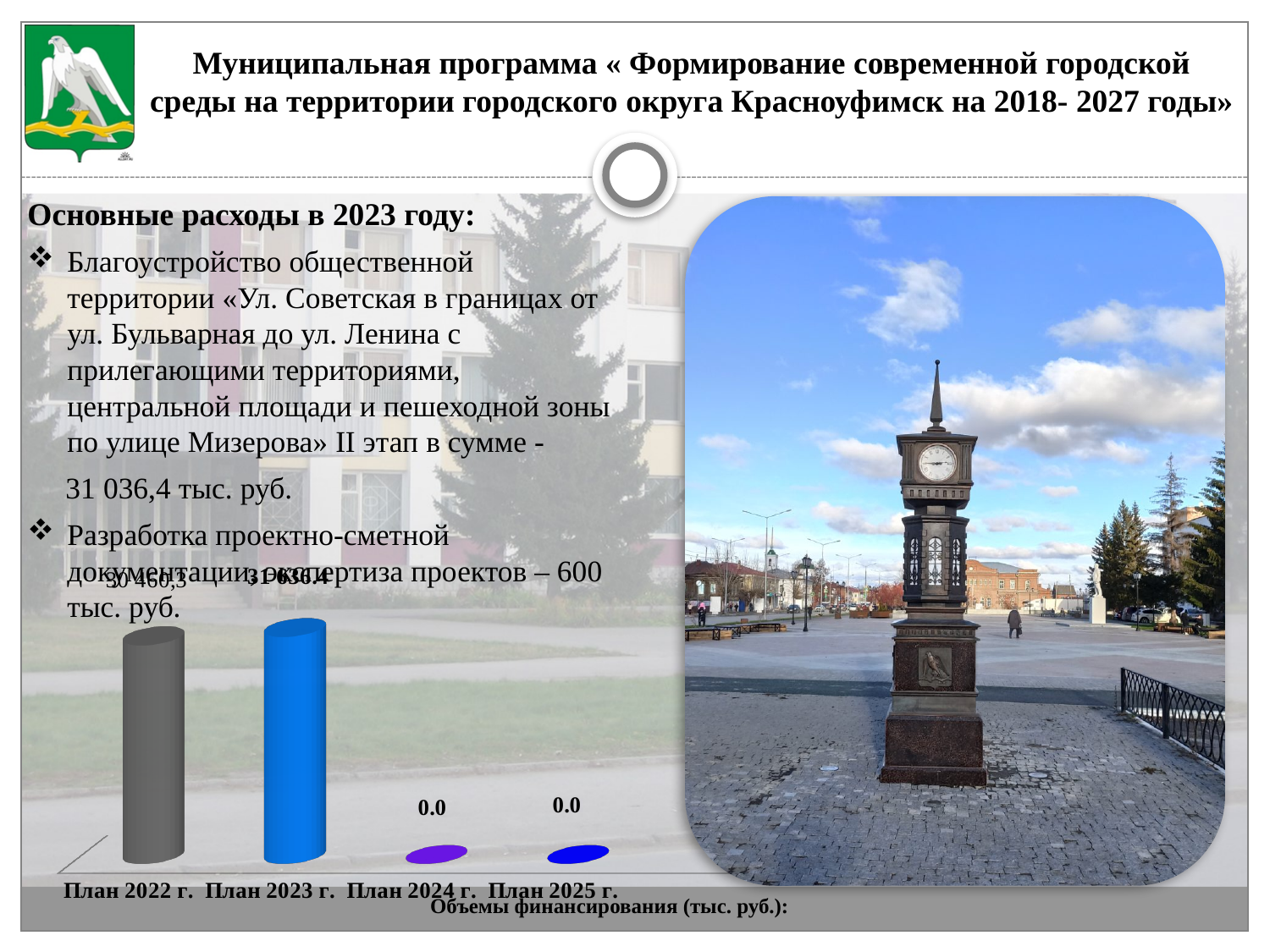
What colour is the bar for План 2022 г. in the chart? grey What is the last category on the x axis of the chart? План 2025 г. How many categories are shown on the x axis of the chart? 4 What kind of chart is shown at the bottom left of the slide? bar chart What is the value shown for План 2025 г. in the chart? 0.0 Which is larger in the chart, the value for План 2023 г. or the value for План 2025 г.? План 2023 г. What is the title of the chart? Объемы финансирования (тыс. руб.): Which is larger in the chart, the value for План 2022 г. or the value for План 2024 г.? План 2022 г. What is the value shown for План 2024 г. in the chart? 0.0 What is the first category on the x axis of the chart? План 2022 г. Do the values in the chart rise or fall from План 2023 г. to План 2025 г.? fall